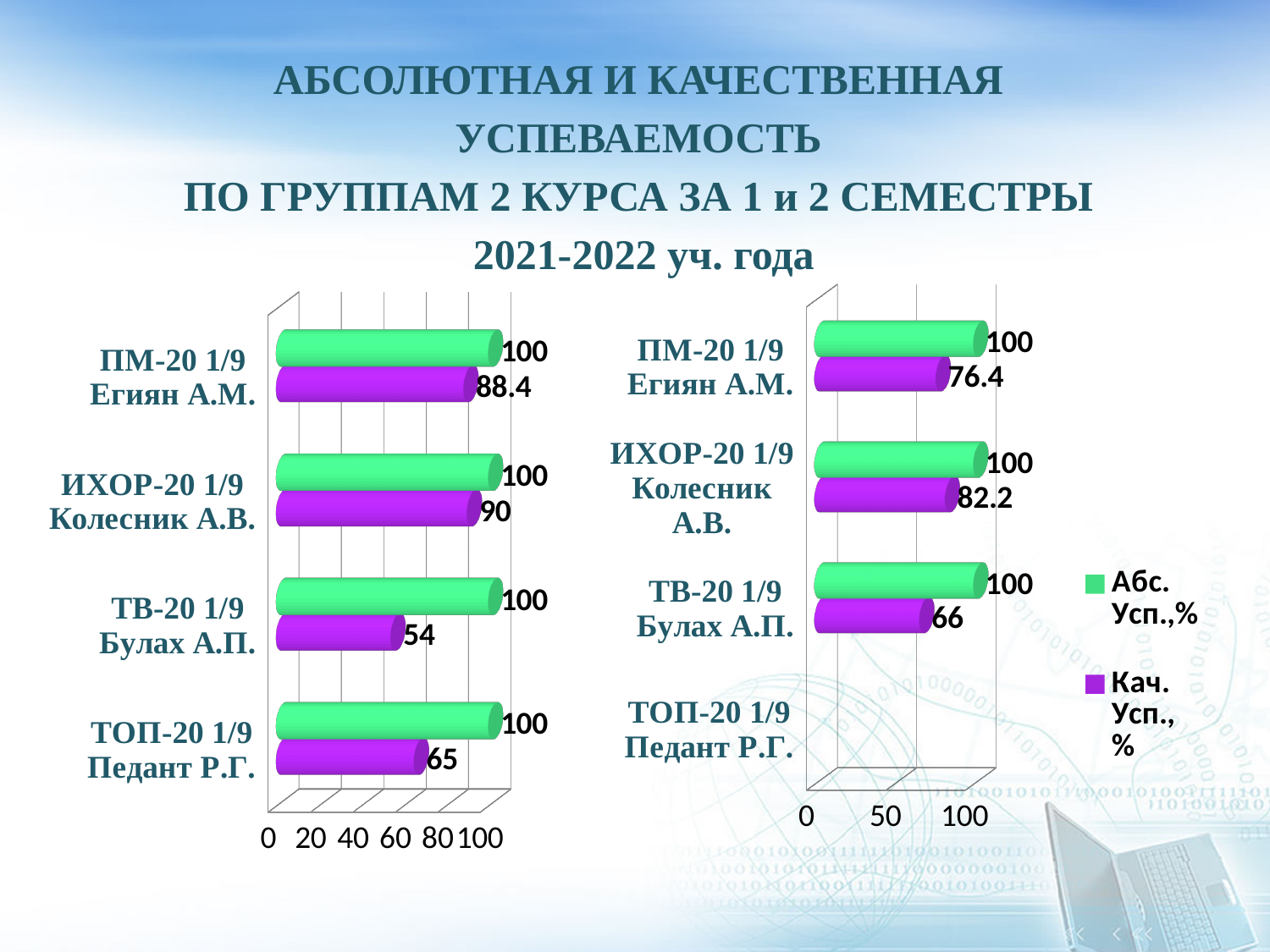
On the left chart, which group has the highest Кач. Усп.,% value? ИХОР-20 1/9 Колесник А.В. How many series does the legend on the right chart list? 2 On the right chart, what is the Кач. Усп.,% value for ИХОР-20 1/9 Колесник А.В.? 82.2 Is the Кач. Усп.,% value for ПМ-20 1/9 Егиян А.М. larger on the left chart or on the right chart? left chart On the left chart, which group has the lowest Кач. Усп.,% value? ТВ-20 1/9 Булах А.П. On the right chart, which group has the lowest Кач. Усп.,% value? ТВ-20 1/9 Булах А.П. On the right chart, what is the difference between the Кач. Усп.,% values for ИХОР-20 1/9 Колесник А.В. and ПМ-20 1/9 Егиян А.М.? 5.8 On the left chart, what is the difference between the Абс. Усп.,% and Кач. Усп.,% values for ТОП-20 1/9 Педант Р.Г.? 35 On the left chart, what is the Кач. Усп.,% value for ПМ-20 1/9 Егиян А.М.? 88.4 What type of chart is the left chart? bar chart On the left chart, what is the Кач. Усп.,% value for ТВ-20 1/9 Булах А.П.? 54 On the right chart, what is the Абс. Усп.,% value for ТВ-20 1/9 Булах А.П.? 100